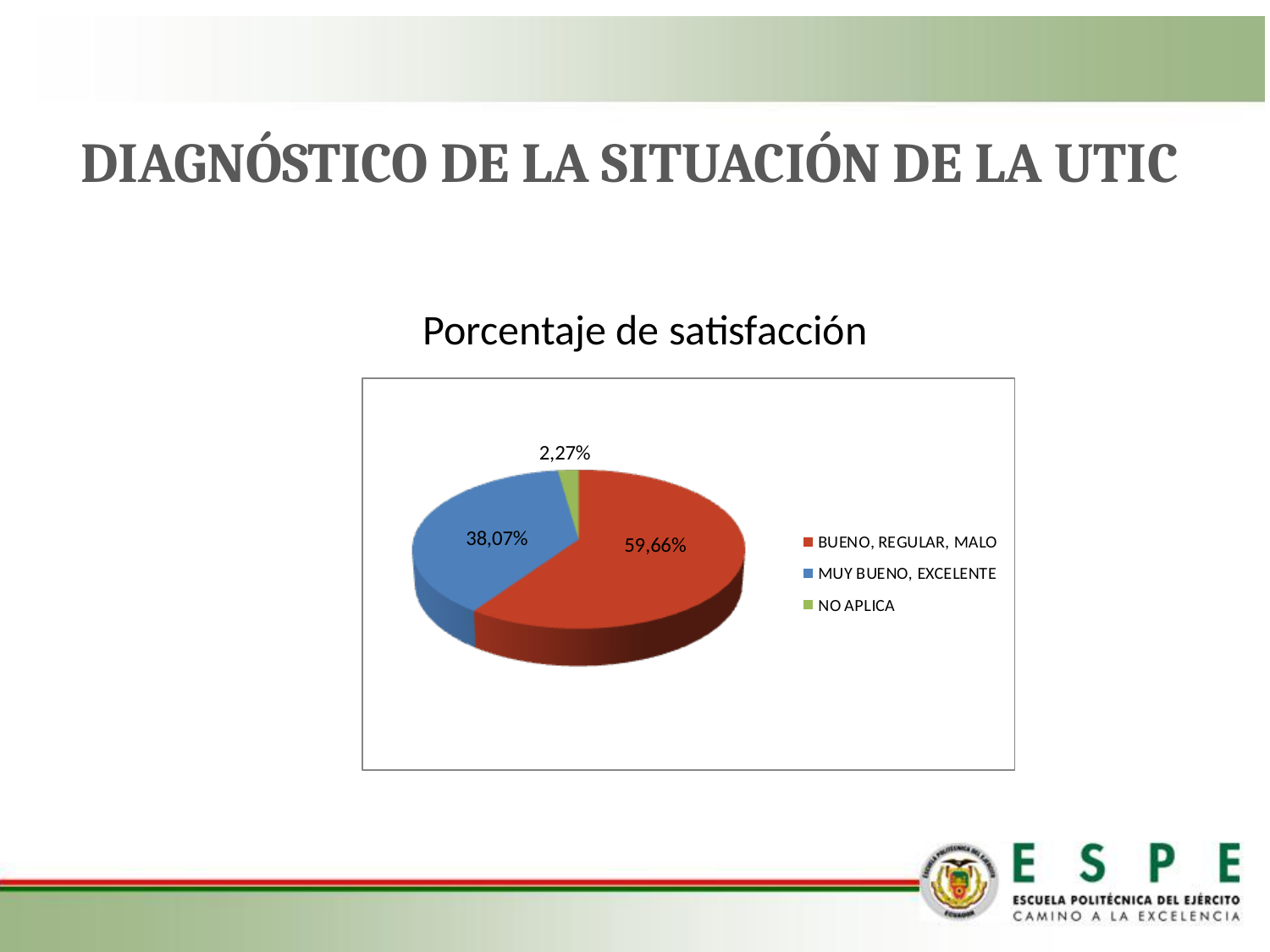
Which is larger, the share for MUY BUENO, EXCELENTE or the share for NO APLICA? MUY BUENO, EXCELENTE What type of chart is shown on the slide? pie chart Which category has the smallest share of the pie? NO APLICA How many categories does the legend list? 3 What is the title of the chart? Porcentaje de satisfacción What percentage is shown for MUY BUENO, EXCELENTE? 38,07% What colour is the slice for NO APLICA? green What percentage is shown for BUENO, REGULAR, MALO? 59,66% What percentage is shown for NO APLICA? 2,27% What is the difference in percentage points between BUENO, REGULAR, MALO and MUY BUENO, EXCELENTE? 21,59 Which category has the largest share of the pie? BUENO, REGULAR, MALO